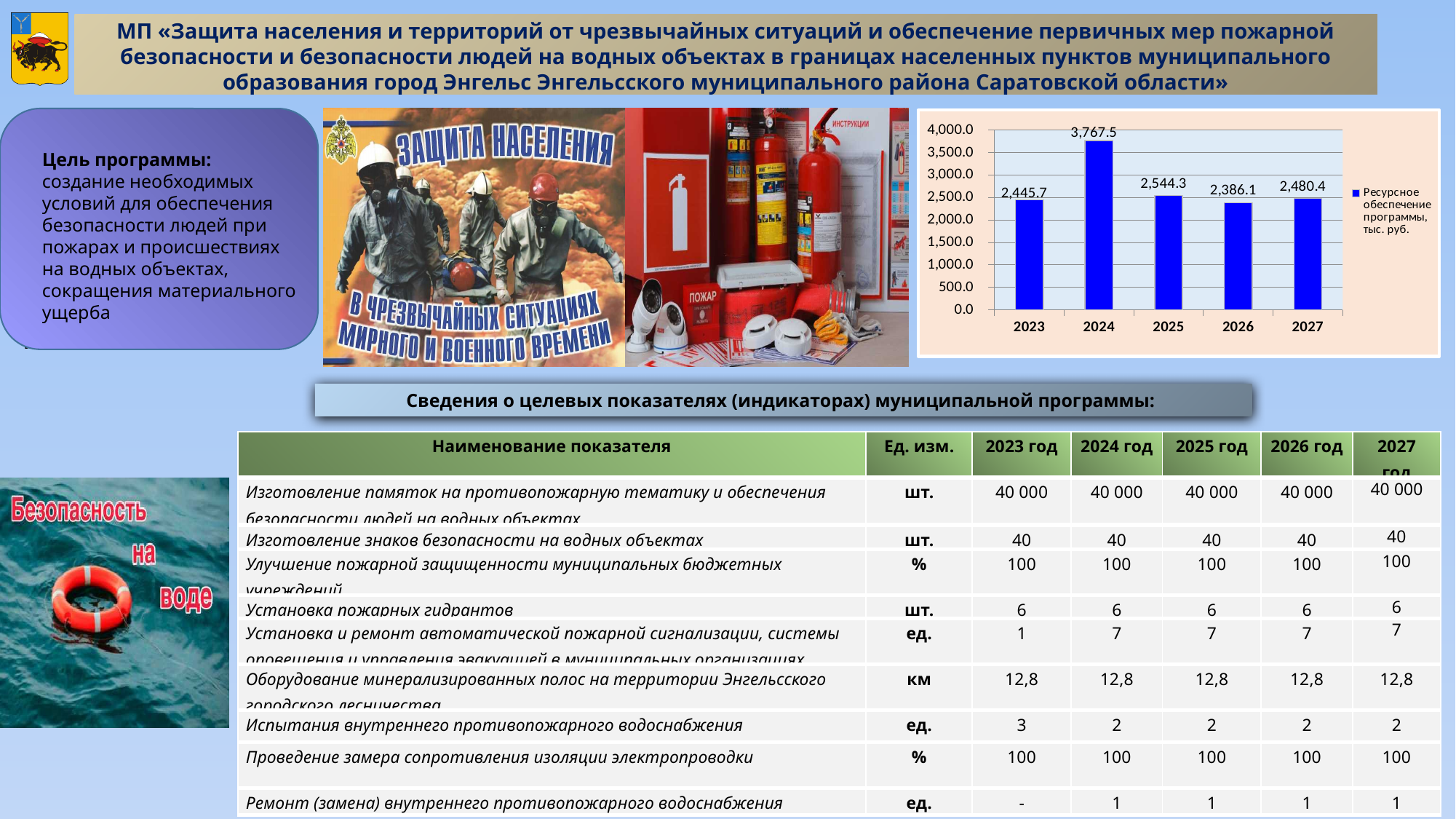
What is the legend entry of the bar chart? Ресурсное обеспечение программы, тыс. руб. Which year has the highest value in the bar chart? 2024 Is the value for 2024 in the bar chart greater or less than 3,500.0? greater What kind of chart is shown on the slide? bar chart What is the difference between the values for 2025 and 2026 in the bar chart? 158.2 What is the value for 2024 in the bar chart? 3,767.5 What is the value for 2023 in the bar chart? 2,445.7 Which is larger in the bar chart, the value for 2025 or the value for 2027? 2025 Which year has the lowest value in the bar chart? 2026 What is the value for 2027 in the bar chart? 2,480.4 How many years are shown on the x axis of the bar chart? 5 What is the difference between the values for 2024 and 2023 in the bar chart? 1,321.8